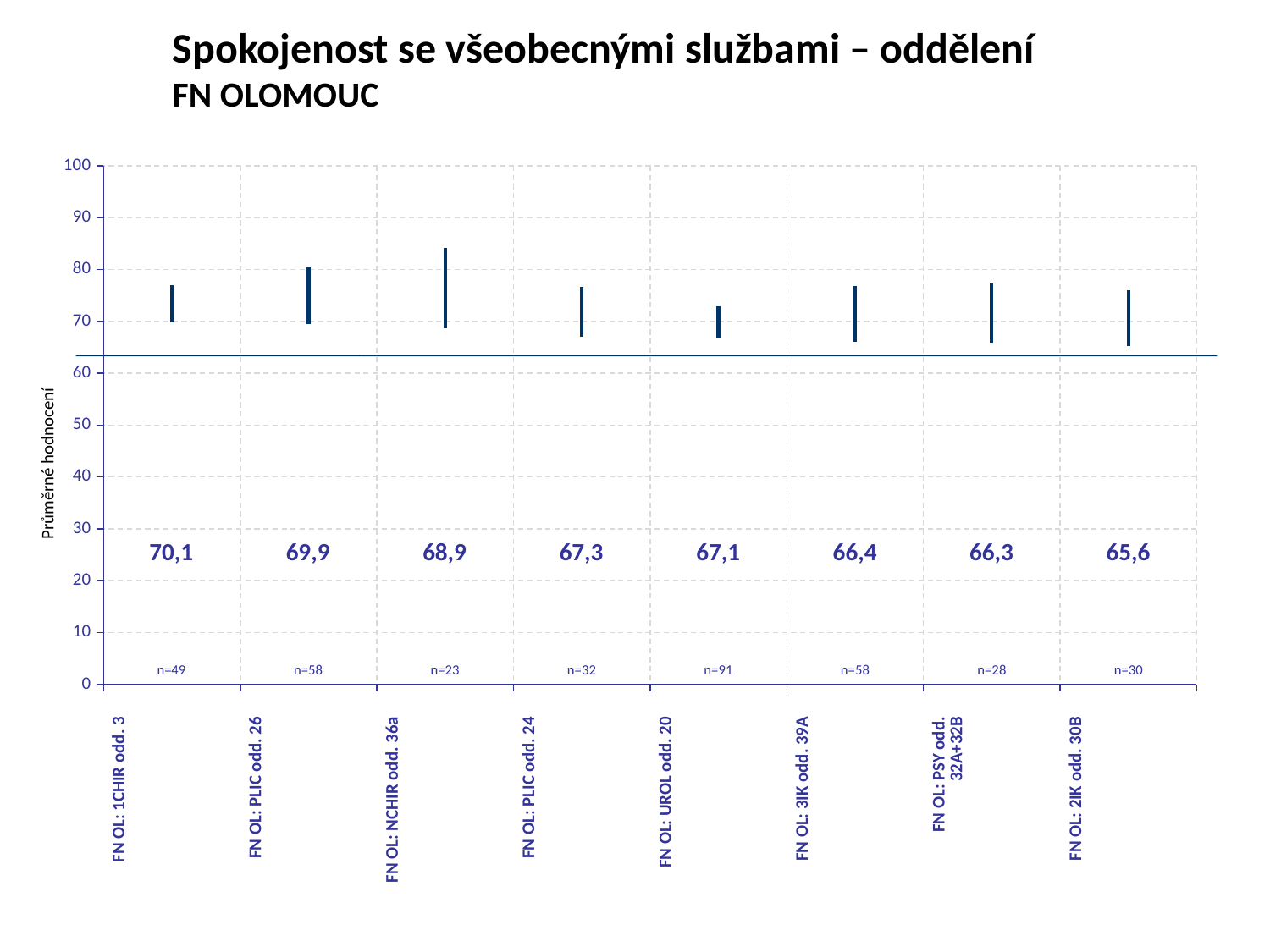
What is the difference between the average rating of FN OL: NCHIR odd. 36a and FN OL: PLIC odd. 24? 1,6 What is the sample size (n) shown for FN OL: UROL odd. 20? n=91 Which department has the highest average rating? FN OL: 1CHIR odd. 3 What is the average rating shown for FN OL: PSY odd. 32A+32B? 66,3 What is the difference between the average rating of FN OL: 1CHIR odd. 3 and FN OL: 2IK odd. 30B? 4,5 What is the average rating shown for FN OL: 1CHIR odd. 3? 70,1 What is the average rating shown for FN OL: UROL odd. 20? 67,1 Which department has the lowest average rating? FN OL: 2IK odd. 30B Which has a higher average rating, FN OL: PLIC odd. 26 or FN OL: PLIC odd. 24? FN OL: PLIC odd. 26 What is the label of the vertical axis? Průměrné hodnocení Do the average ratings rise or fall from left to right across the chart? fall How many departments are shown on the chart? 8